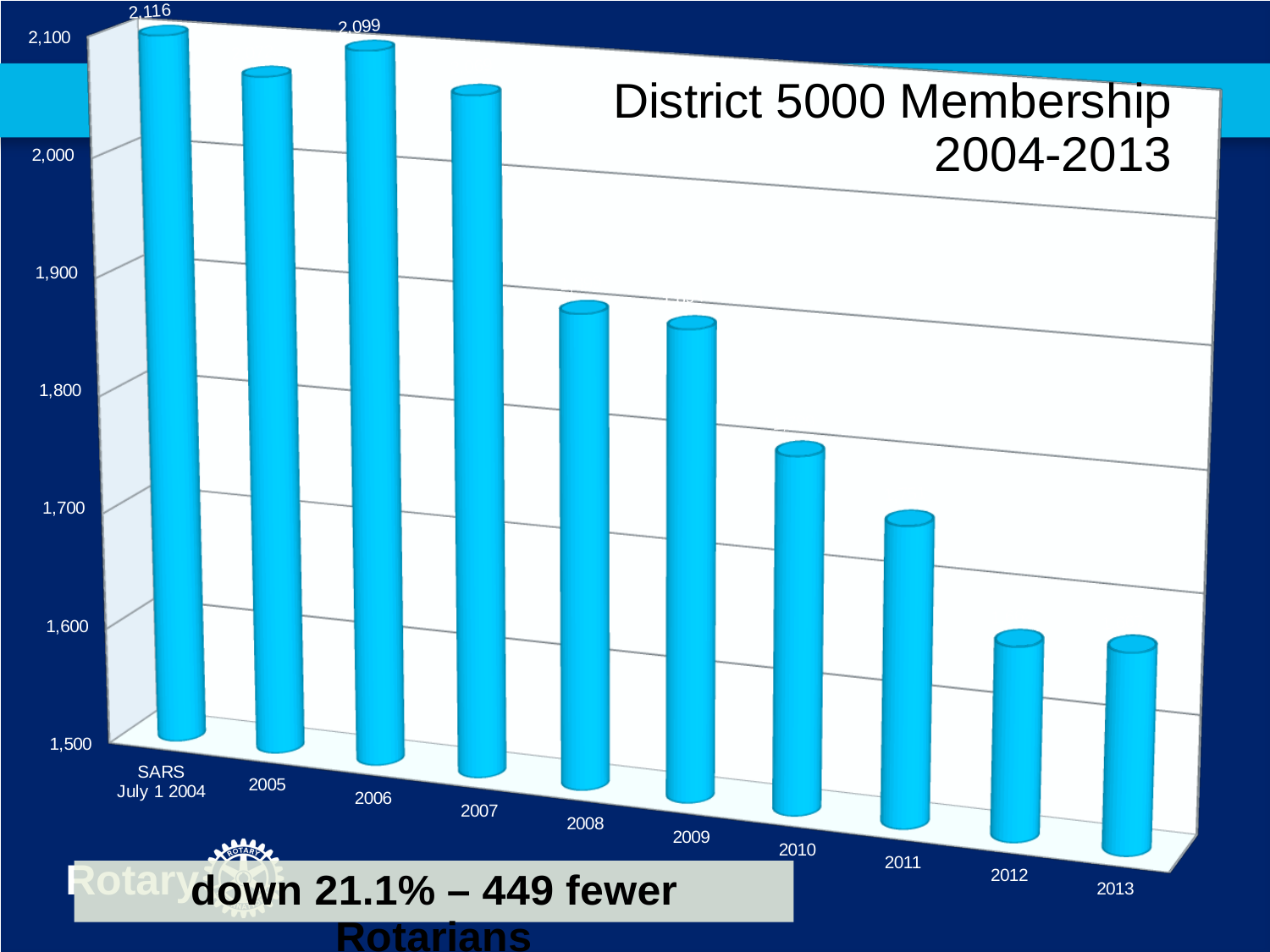
What is the difference between the 2004 value (2,116) and the 2006 value (2,099)? 17 Is the value for 2010 greater or less than 1,700? greater Which year has the highest membership? SARS July 1 2004 What kind of chart is shown on the slide? bar chart Is the value for 2013 greater or less than 1,600? greater Is the value for 2005 greater or less than 2,000? greater Do membership values generally rise or fall from 2004 to 2013? fall What is the membership value shown for SARS July 1 2004? 2,116 Which is larger, the membership for 2004 or for 2006? 2004 How many years (bars) are shown in the chart? 10 What is the membership value shown for 2006? 2,099